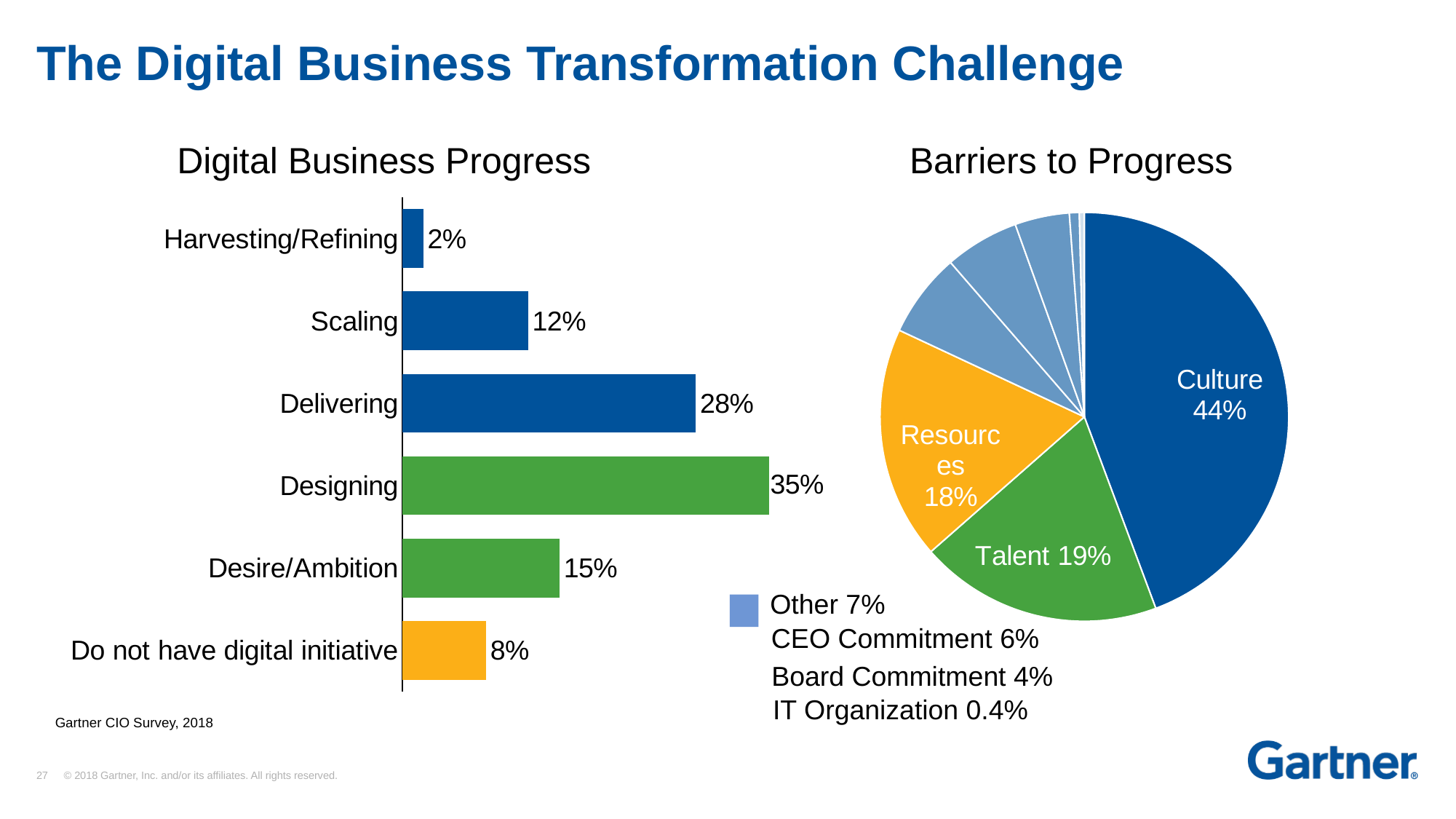
What kind of chart is the Barriers to Progress chart? Pie chart In the Barriers to Progress chart, which barrier has the largest slice? Culture How many categories are shown in the Digital Business Progress chart? 6 In the Digital Business Progress chart, what is the difference between Designing and Delivering? 7% In the Digital Business Progress chart, what is the value for Delivering? 28% In the Barriers to Progress chart, what share does Culture have? 44% In the Digital Business Progress chart, which category has the lowest value? Harvesting/Refining In the Digital Business Progress chart, what is the value for Do not have digital initiative? 8% What kind of chart is the Digital Business Progress chart? Bar chart In the Digital Business Progress chart, which category has the highest value? Designing In the Barriers to Progress chart, what is the difference between Talent and Resources? 1% In the Digital Business Progress chart, which is larger, Scaling or Desire/Ambition? Desire/Ambition